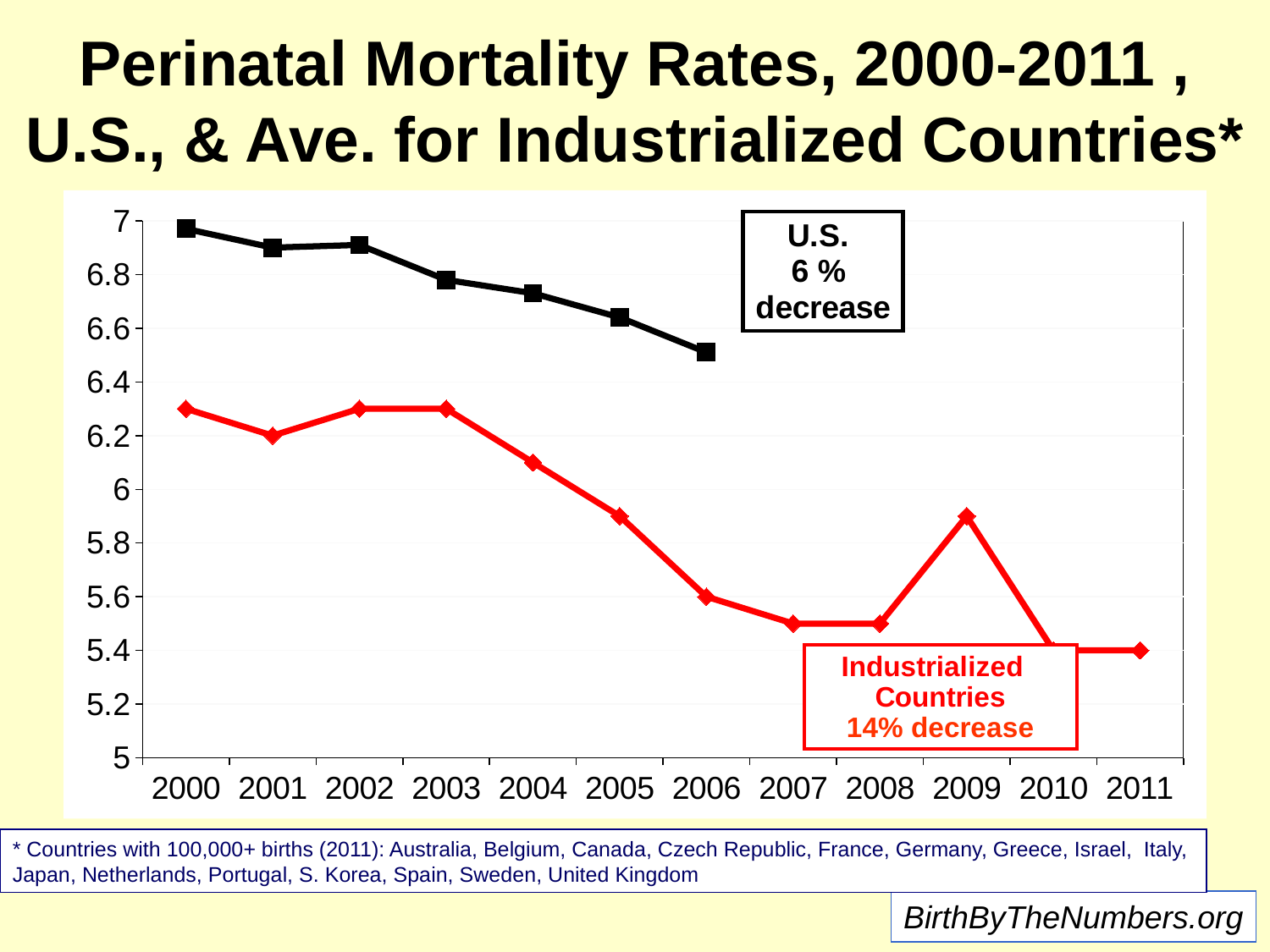
How many years are shown along the x axis? 12 What percentage decrease does the chart annotation give for the Industrialized Countries? 14% decrease What is the Industrialized Countries value for 2011? 5.4 Is the U.S. value for 2006 greater or less than 6.6? less Is the U.S. value for 2000 greater or less than 6.8? greater Does the U.S. series rise or fall from 2000 to 2006? fall Is the Industrialized Countries value for 2009 greater or less than 5.8? greater How many data points does the U.S. series have? 7 How many series are plotted on the chart? 2 What kind of chart is shown on the slide? line chart What is the Industrialized Countries value for 2006? 5.6 In which year is the U.S. series at its lowest? 2006